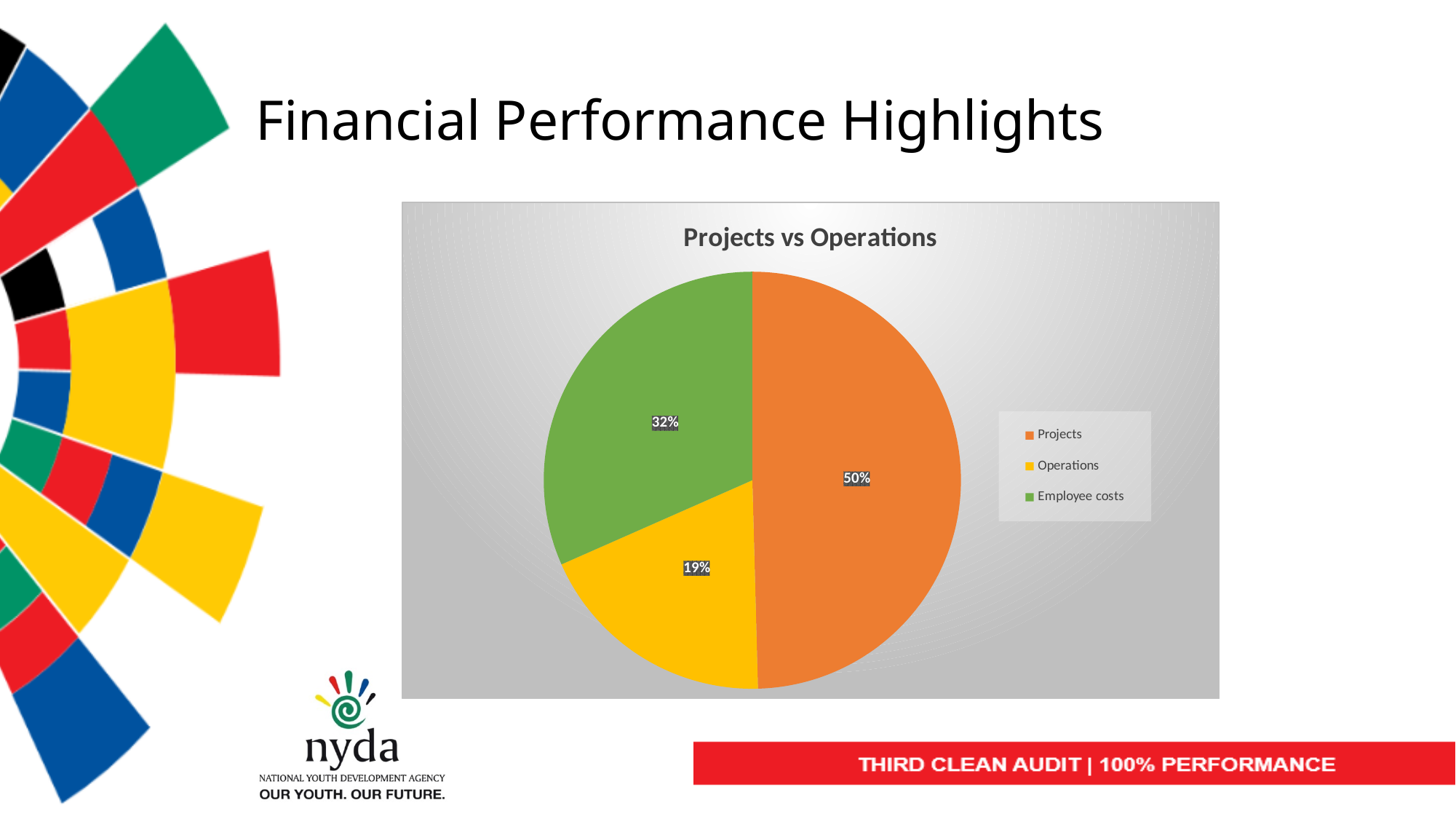
What kind of chart is shown on the slide? Pie chart How many slices does the pie chart have? 3 What is the difference in percentage points between the Projects slice and the Employee costs slice? 18 Which category has the smallest slice of the pie? Operations Which is larger, the Operations slice or the Employee costs slice? Employee costs What colour is the Employee costs slice? Green What share of the pie does Employee costs account for? 32% Which category has the largest slice of the pie? Projects What share of the pie does Projects account for? 50% What share of the pie does Operations account for? 19% What is the title of the chart? Projects vs Operations What is the difference in percentage points between the Employee costs slice and the Operations slice? 13